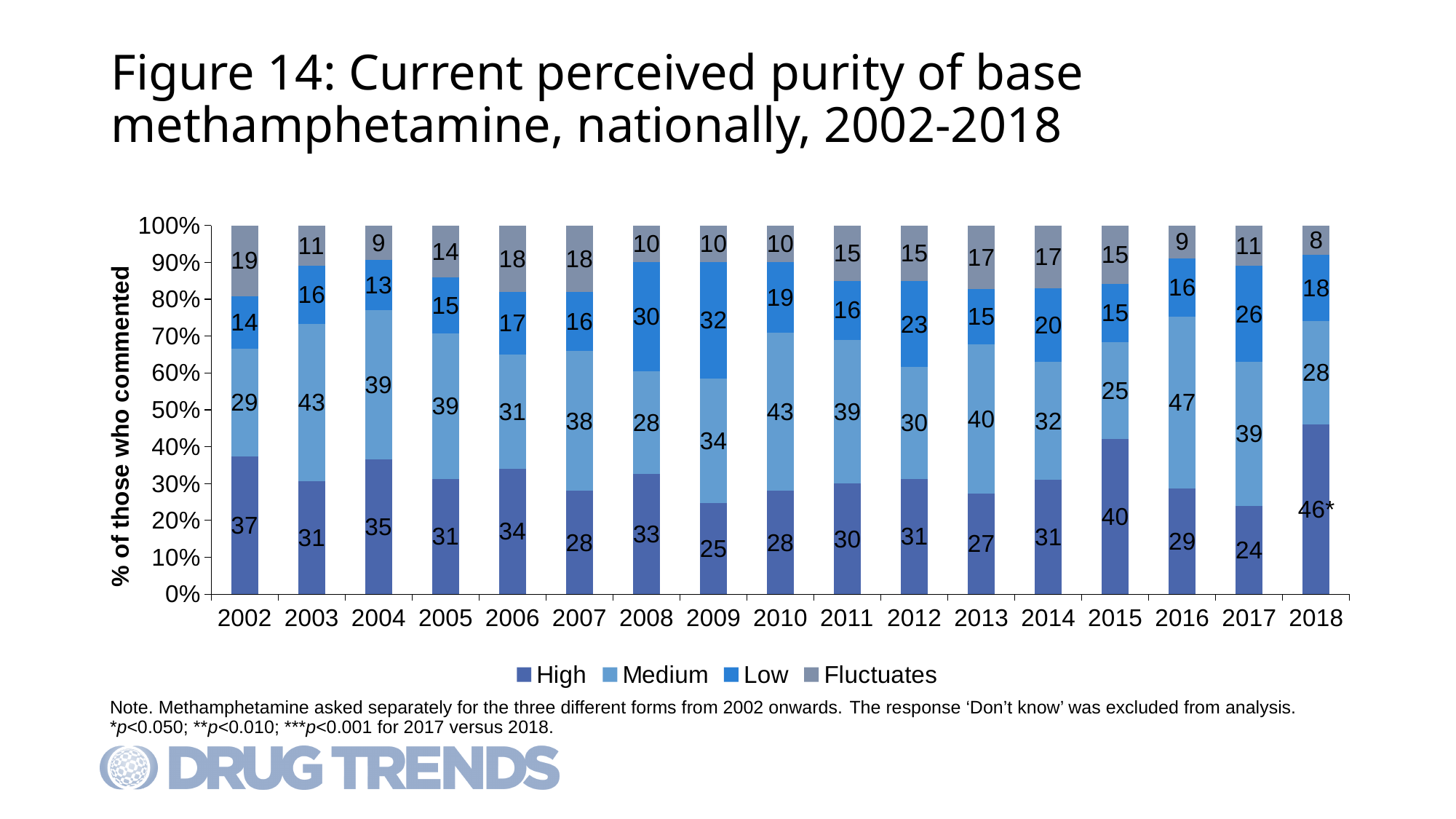
In which year is the High value the largest? 2018 What kind of chart is shown on the slide? Stacked bar chart What is the Low value for 2009? 32 How many series does the legend list? 4 What is the label on the vertical axis? % of those who commented In which year is the High value the smallest? 2017 What is the Fluctuates value for 2018? 8 Which is larger, the Low value in 2008 or the Low value in 2011? 2008 What is the Medium value for 2016? 47 How many years are shown on the x axis? 17 What is the difference between the Medium value in 2016 and the Medium value in 2015? 22 What percentage of those who commented rated the purity of base methamphetamine as High in 2002? 37